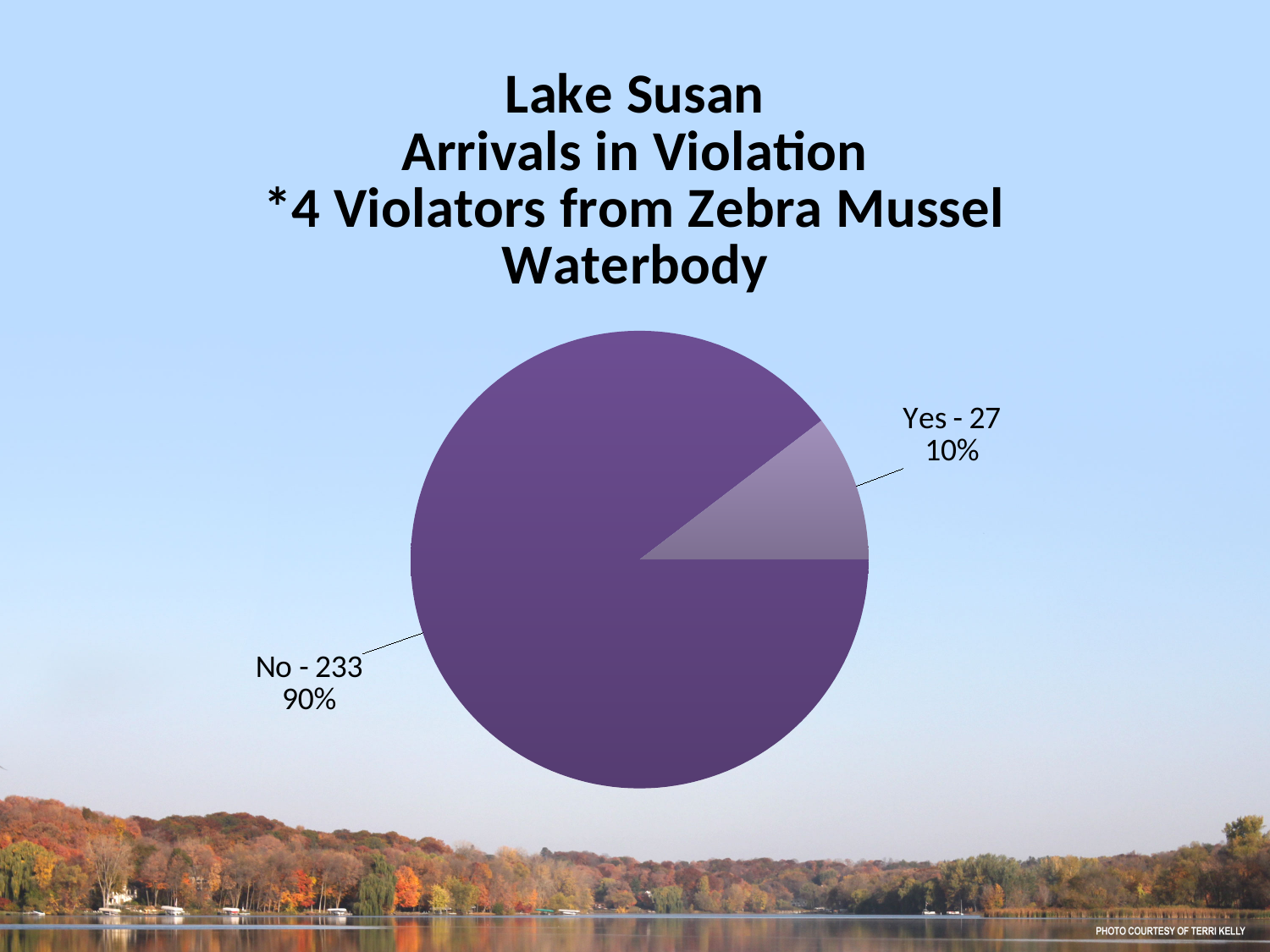
Which is larger, the Yes slice or the No slice? No What share of the pie does the No slice represent? 90% How many arrivals were not in violation (No)? 233 Which slice is the largest? No Which slice is the smallest? Yes How many slices does the pie chart have? 2 How many arrivals were in violation (Yes)? 27 What is the difference between the No count and the Yes count? 206 What is the total number of arrivals represented in the pie chart? 260 What percentage of arrivals were in violation (Yes)? 10% What is the first line of the chart's title? Lake Susan What kind of chart is shown on the slide? pie chart